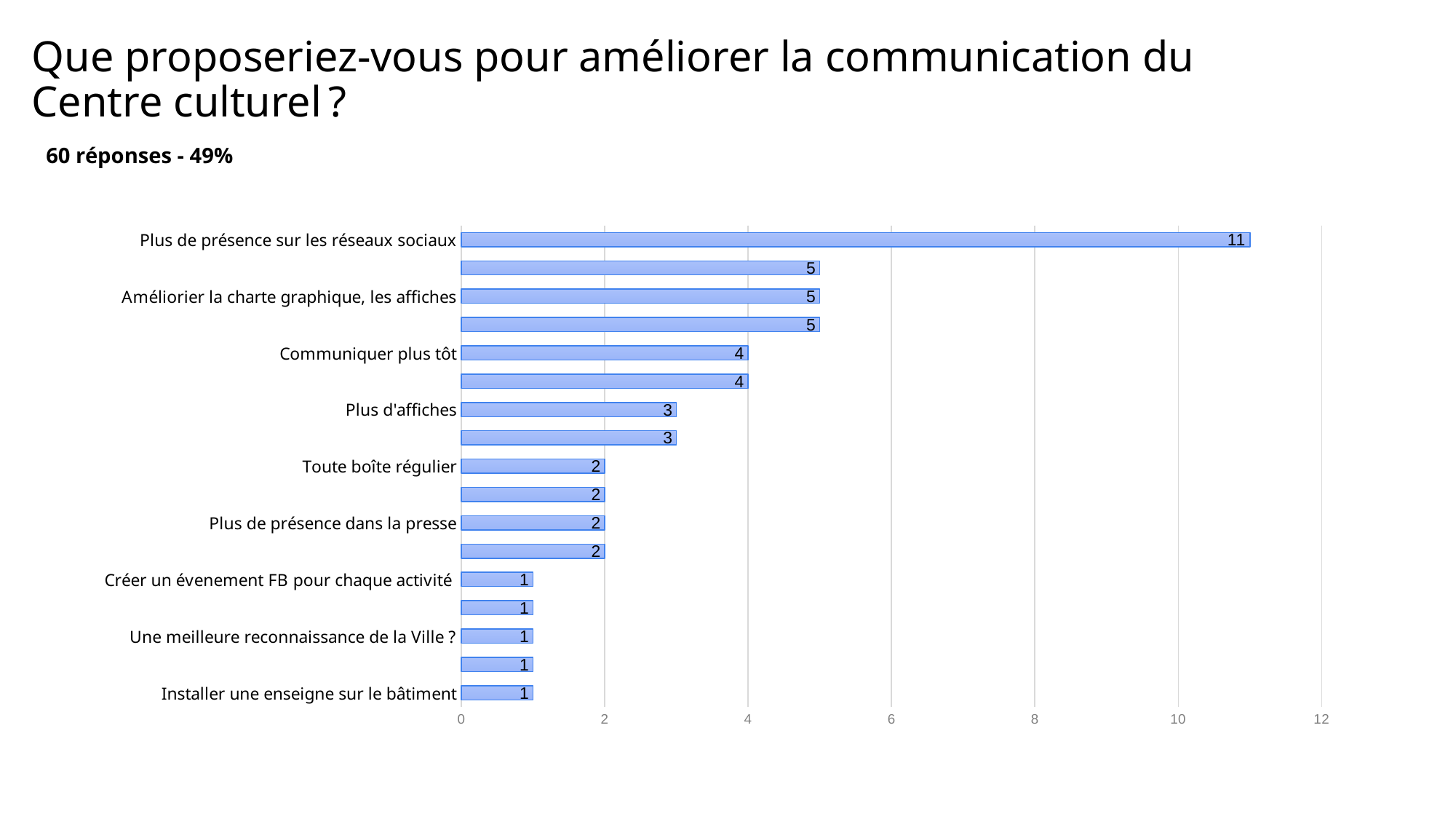
What is the highest tick value shown on the horizontal axis? 12 What kind of chart is shown on the slide? bar chart What is the difference between the values for "Plus de présence sur les réseaux sociaux" and "Améliorier la charte graphique, les affiches"? 6 What value is shown for "Plus de présence sur les réseaux sociaux"? 11 What value is shown for "Communiquer plus tôt"? 4 What value is shown for "Plus d'affiches"? 3 Which category has the highest value? Plus de présence sur les réseaux sociaux Is the value for "Plus de présence sur les réseaux sociaux" greater or less than 10? greater How many bars are plotted in the chart? 17 What value is shown for "Améliorier la charte graphique, les affiches"? 5 What value is shown for "Installer une enseigne sur le bâtiment"? 1 Which is larger, the value for "Communiquer plus tôt" or the value for "Toute boîte régulier"? Communiquer plus tôt